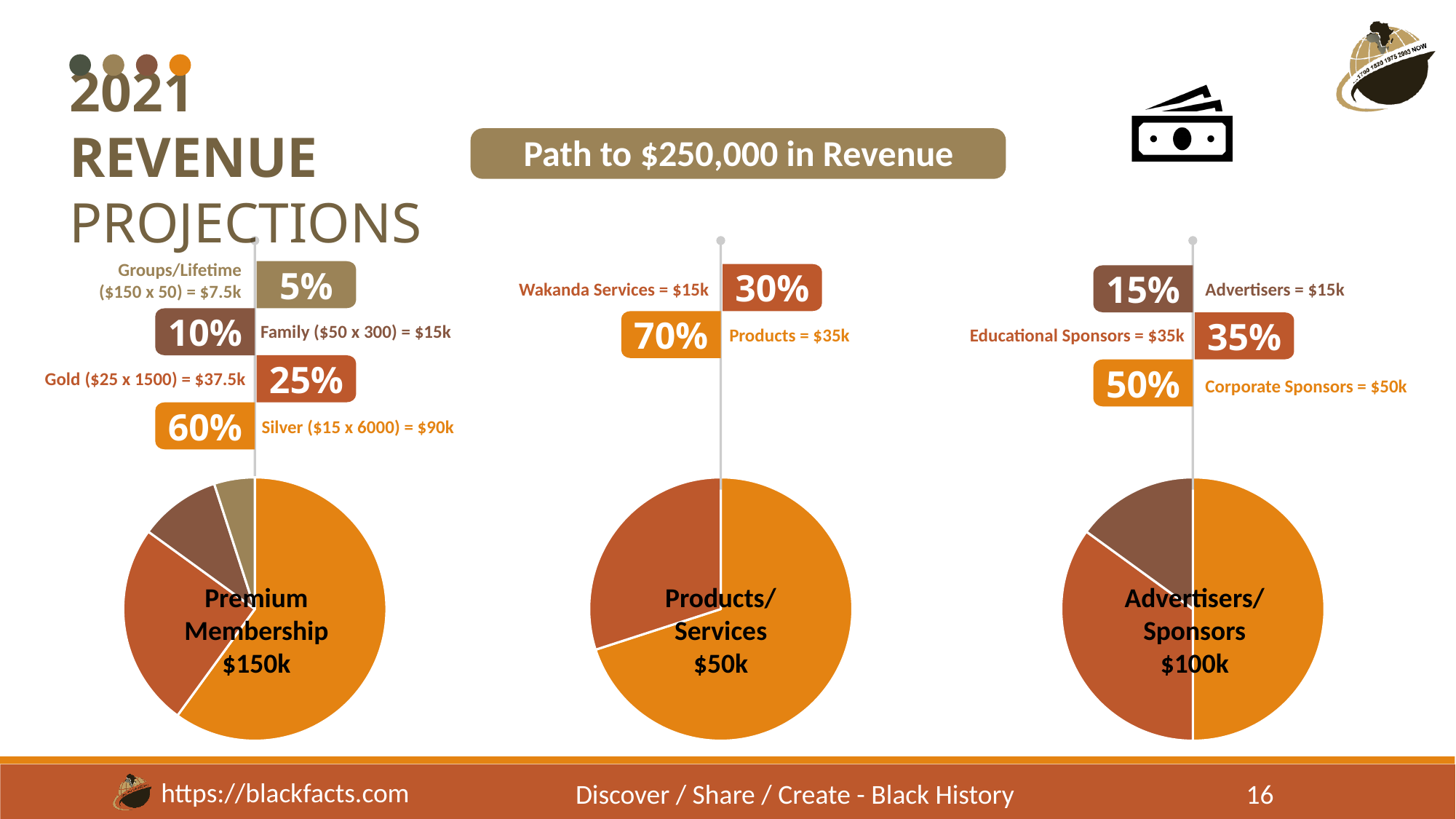
In the Premium Membership pie chart, what share does Silver have? 60% In the Advertisers/Sponsors pie chart, what is the difference in share between Corporate Sponsors and Advertisers? 35% In the Premium Membership pie chart, how many categories are there? 4 In the Premium Membership pie chart, which category has the smallest share? Groups/Lifetime In the Premium Membership pie chart, what is the revenue value for Gold? $37.5k In the Advertisers/Sponsors pie chart, which is larger: Educational Sponsors or Advertisers? Educational Sponsors How many pie charts are on the slide? 3 What kind of charts are shown on the slide? Pie charts In the Products/Services pie chart, what share do Products have? 70% In the Advertisers/Sponsors pie chart, which category has the largest share? Corporate Sponsors In the Products/Services pie chart, what is the revenue value for Wakanda Services? $15k What total revenue does the Premium Membership pie chart represent? $150k